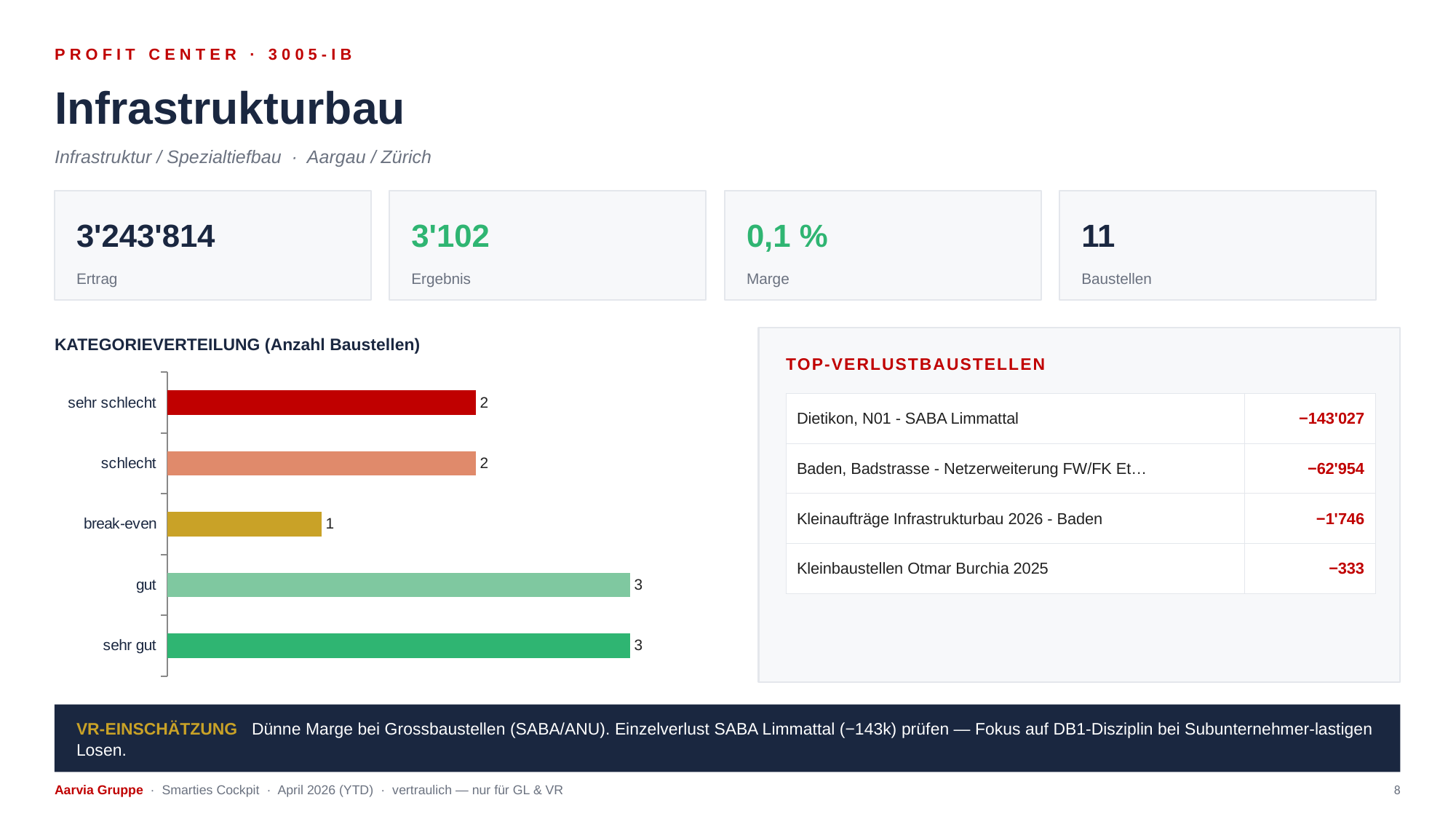
What is the value for 'gut' in the KATEGORIEVERTEILUNG chart? 3 What type of chart is shown under KATEGORIEVERTEILUNG (Anzahl Baustellen)? bar chart What is the value for 'sehr schlecht' in the KATEGORIEVERTEILUNG chart? 2 In the KATEGORIEVERTEILUNG chart, what is the difference between 'sehr gut' and 'break-even'? 2 Which category has the lowest value in the KATEGORIEVERTEILUNG chart? break-even What colour is the 'sehr schlecht' bar in the KATEGORIEVERTEILUNG chart? red How many categories does the KATEGORIEVERTEILUNG chart show? 5 What is the value for 'schlecht' in the KATEGORIEVERTEILUNG chart? 2 In the KATEGORIEVERTEILUNG chart, what is the difference between 'gut' and 'schlecht'? 1 What is the value for 'break-even' in the KATEGORIEVERTEILUNG chart? 1 In the KATEGORIEVERTEILUNG chart, which is larger: 'sehr gut' or 'break-even'? sehr gut What is the sum of all bar values in the KATEGORIEVERTEILUNG chart? 11